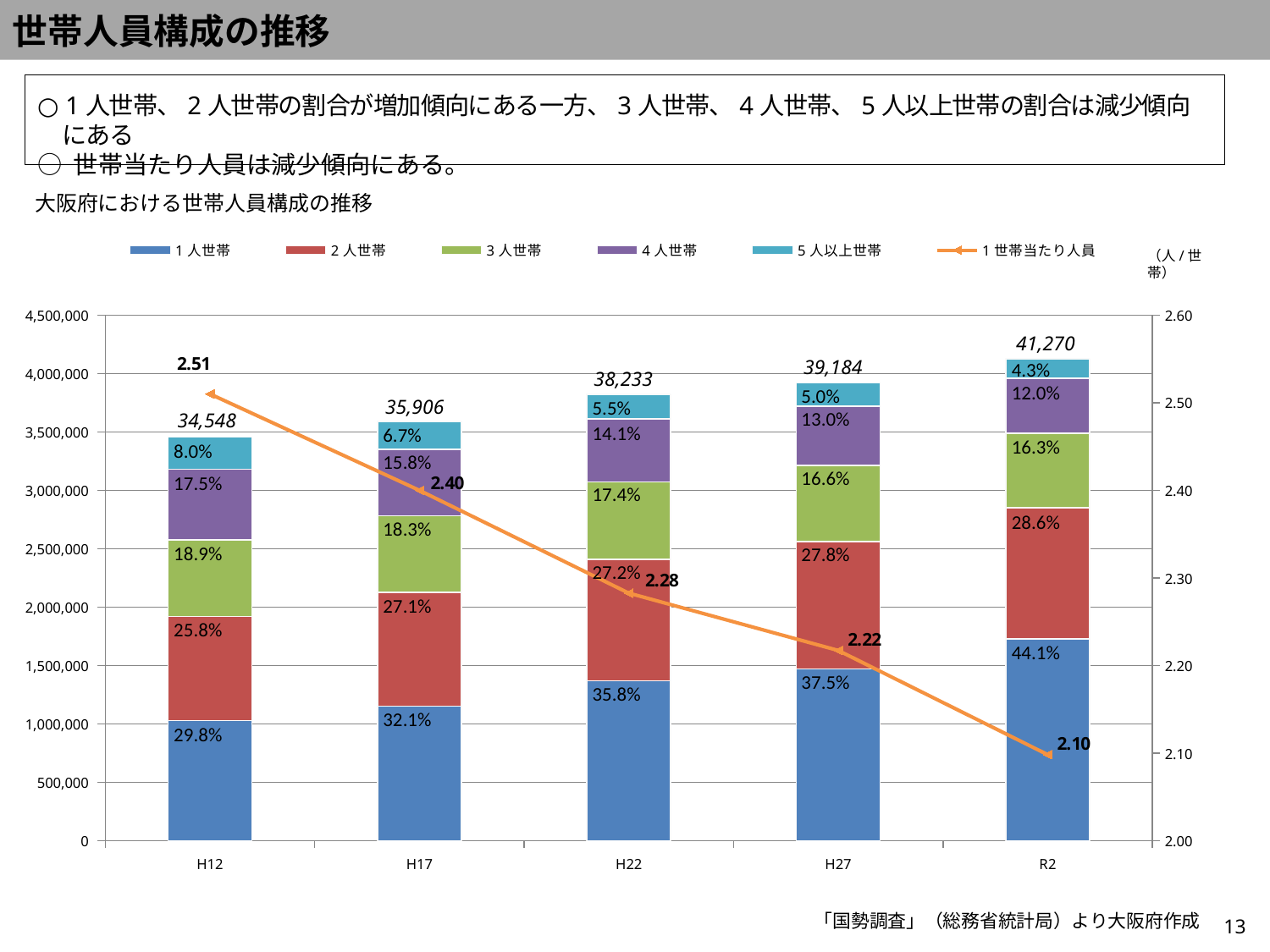
How many series does the legend list? 6 In which year is the share of 1人世帯 highest? R2 Which is larger: the share of 2人世帯 in H12 or in R2? R2 What is the total label shown above the H22 bar? 38,233 What is the difference between the 1世帯当たり人員 values in H12 and R2? 0.41 What is the share of 5人以上世帯 in H17? 6.7% In which year is the 1世帯当たり人員 value lowest? R2 How many years are shown on the x axis? 5 What kind of chart is this? Stacked bar chart with a line Does the 1世帯当たり人員 line rise or fall from H12 to R2? Fall What is the share of 1人世帯 in R2? 44.1% What is the value of 1世帯当たり人員 in H12? 2.51